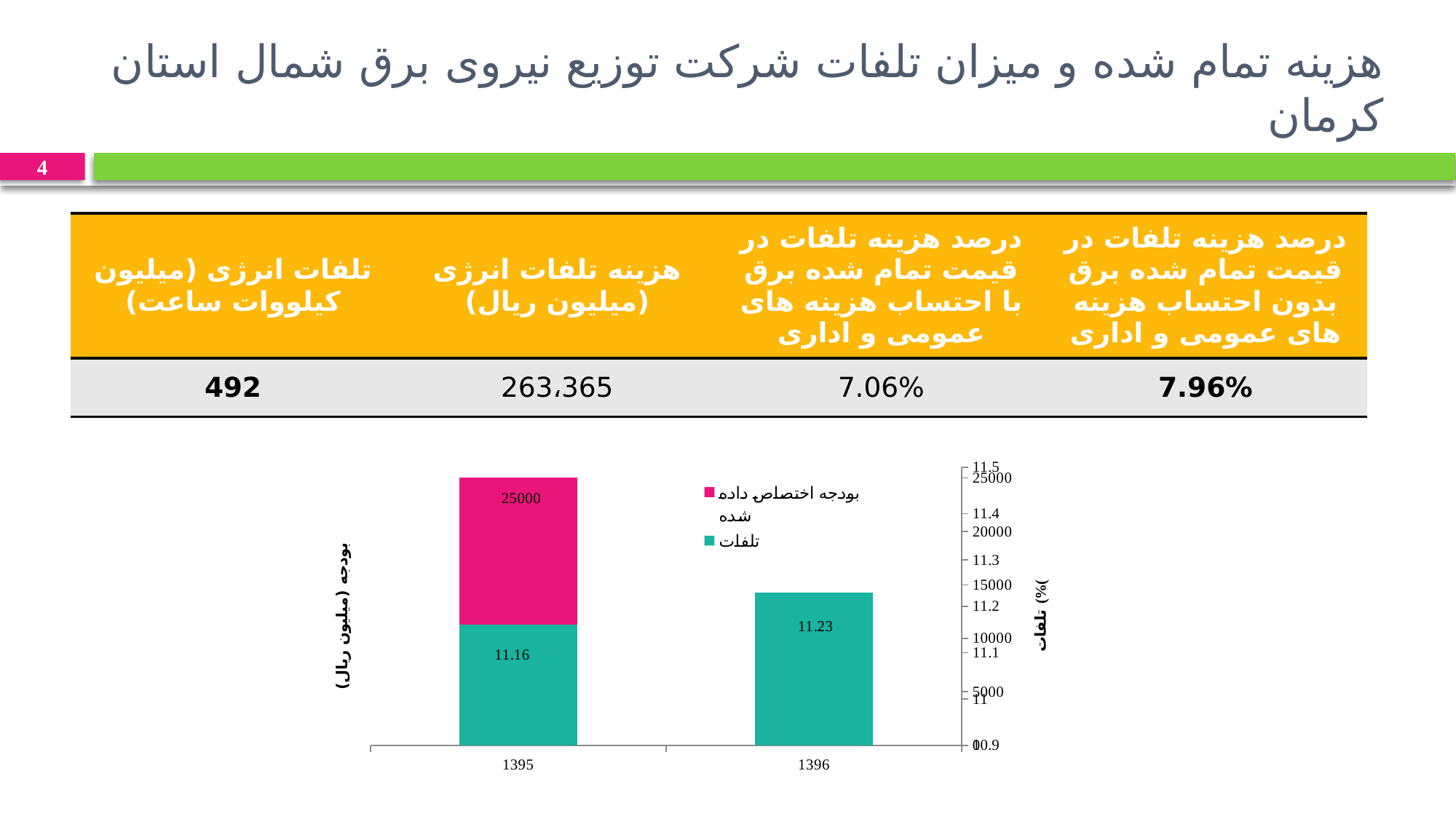
Which series is shown in teal in the chart? تلفات Which year has the lowest تلفات value? 1395 What kind of chart is shown on the slide? bar chart What is the difference between the تلفات values for 1396 and 1395? 0.07 Which series is shown in pink in the chart? بودجه اختصاص داده شده What is the value of تلفات for 1395? 11.16 What is the value of بودجه اختصاص داده شده for 1395? 25000 What is the value of تلفات for 1396? 11.23 Which year has the higher تلفات value, 1395 or 1396? 1396 How many series does the chart legend list? 2 Does the تلفات value rise or fall from 1395 to 1396? rise How many categories are shown on the x axis of the chart? 2